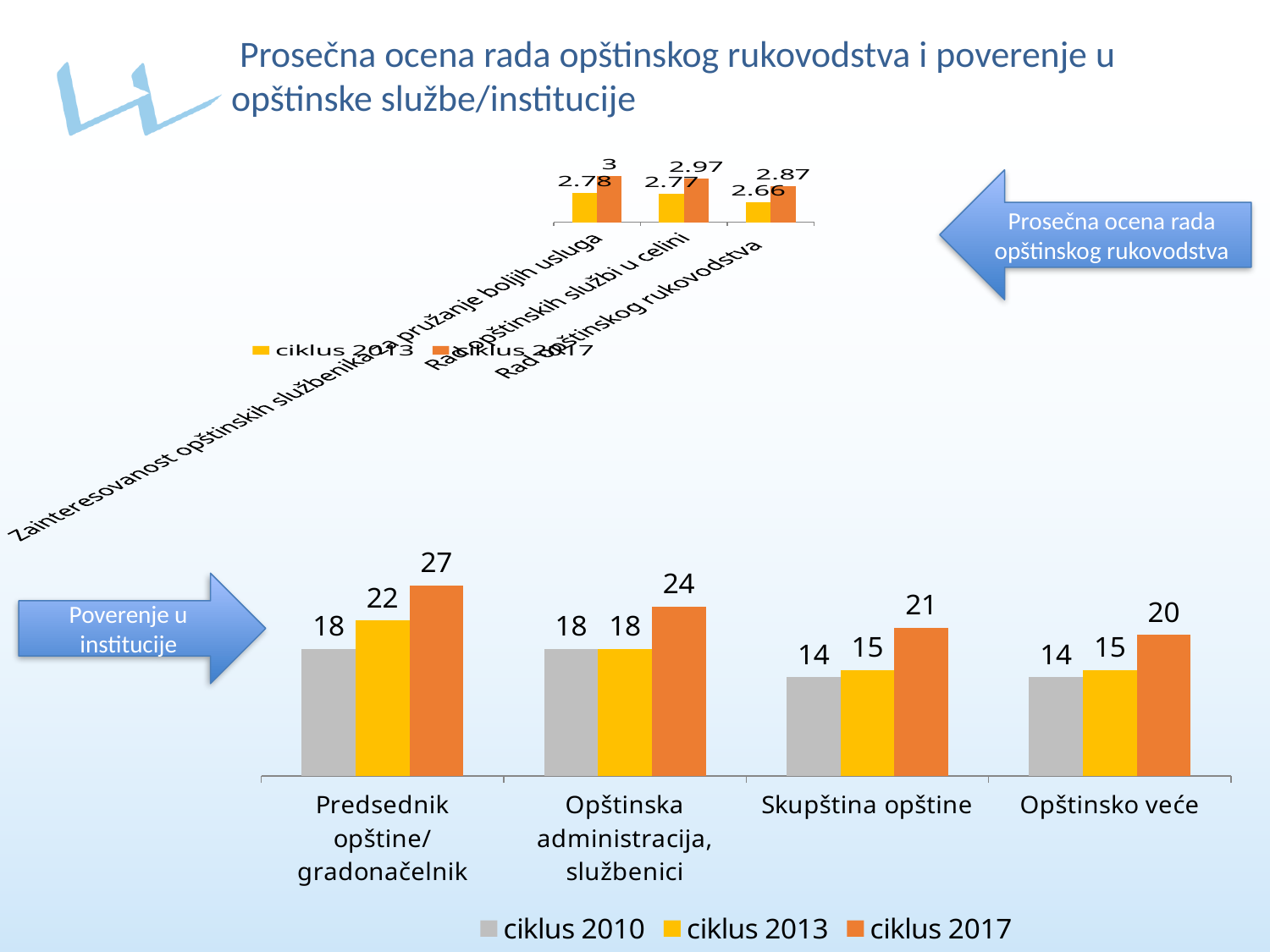
In the bottom chart (Poverenje u institucije), what is the value for ciklus 2017 for Predsednik opštine/gradonačelnik? 27 How many categories are shown in the bottom chart (Poverenje u institucije)? 4 In the bottom chart (Poverenje u institucije), which category has the highest ciklus 2017 value? Predsednik opštine/gradonačelnik In the top chart (Prosečna ocena rada opštinskog rukovodstva), which series does the orange colour represent? ciklus 2017 What kind of chart is the bottom chart (Poverenje u institucije)? Bar chart How many series does the legend of the bottom chart (Poverenje u institucije) list? 3 In the top chart (Prosečna ocena rada opštinskog rukovodstva), what is the ciklus 2017 value for Rad opštinskog rukovodstva? 2.87 In the top chart (Prosečna ocena rada opštinskog rukovodstva), what is the ciklus 2013 value for Rad opštinskih službi u celini? 2.77 In the bottom chart (Poverenje u institucije), what is the value for ciklus 2010 for Skupština opštine? 14 In the bottom chart (Poverenje u institucije), which category has the lowest ciklus 2017 value? Opštinsko veće In the bottom chart (Poverenje u institucije), what is the difference between the ciklus 2017 and ciklus 2010 values for Opštinska administracija, službenici? 6 In the bottom chart (Poverenje u institucije), which is larger: the ciklus 2013 value for Predsednik opštine/gradonačelnik or the ciklus 2013 value for Opštinska administracija, službenici? Predsednik opštine/gradonačelnik